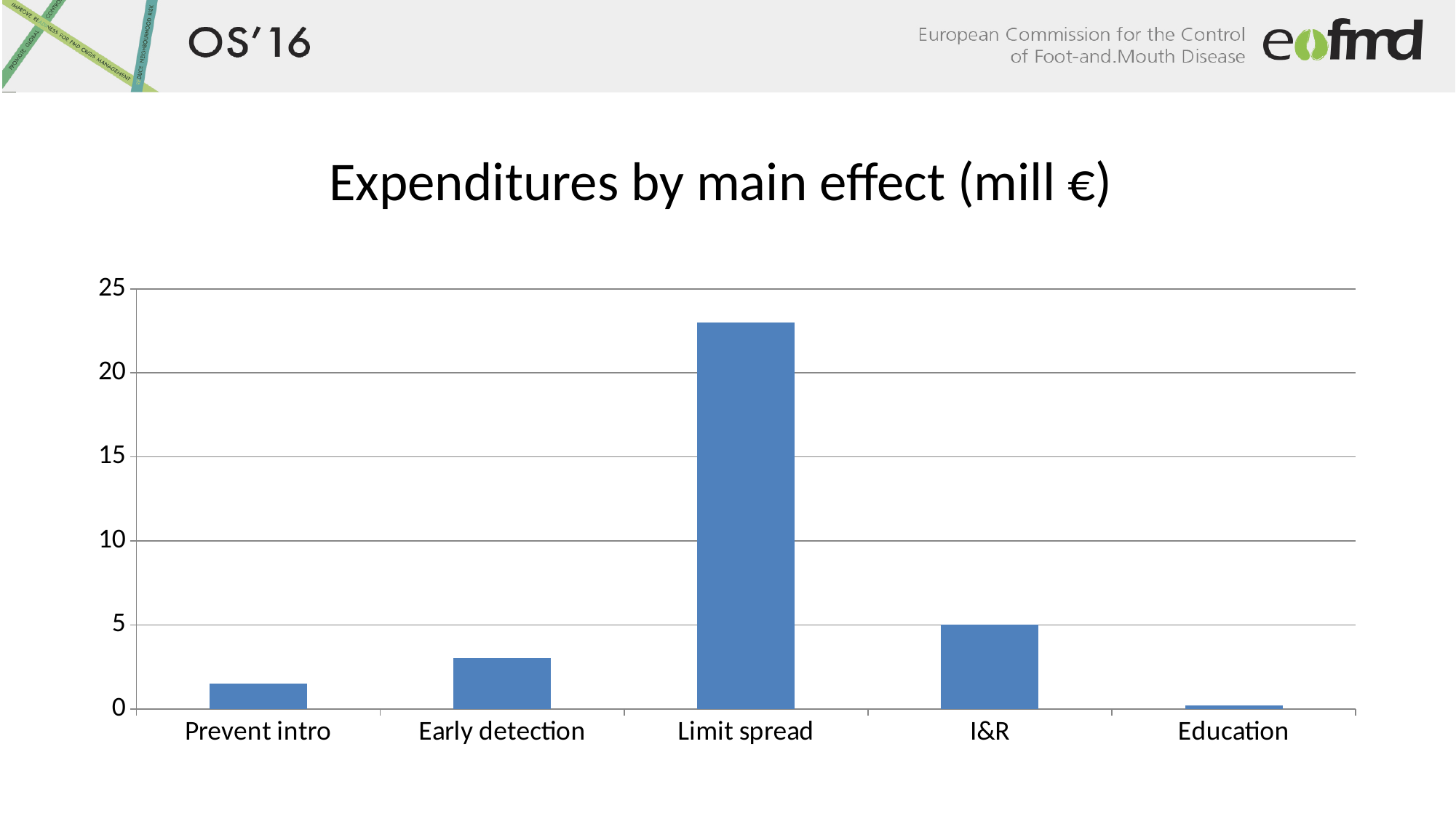
Which category has the highest expenditure? Limit spread Is the value for Early detection greater or less than 5? less Is the value for Education greater or less than 5? less Which is larger, the value for I&R or the value for Early detection? I&R What is the title of the chart? Expenditures by main effect (mill €) Is the value for Prevent intro greater or less than 5? less How many categories are shown on the x axis of the chart? 5 Which category has the lowest expenditure? Education What is the value for I&R? 5 What type of chart is shown on the slide? bar chart Which is larger, the value for Early detection or the value for Prevent intro? Early detection